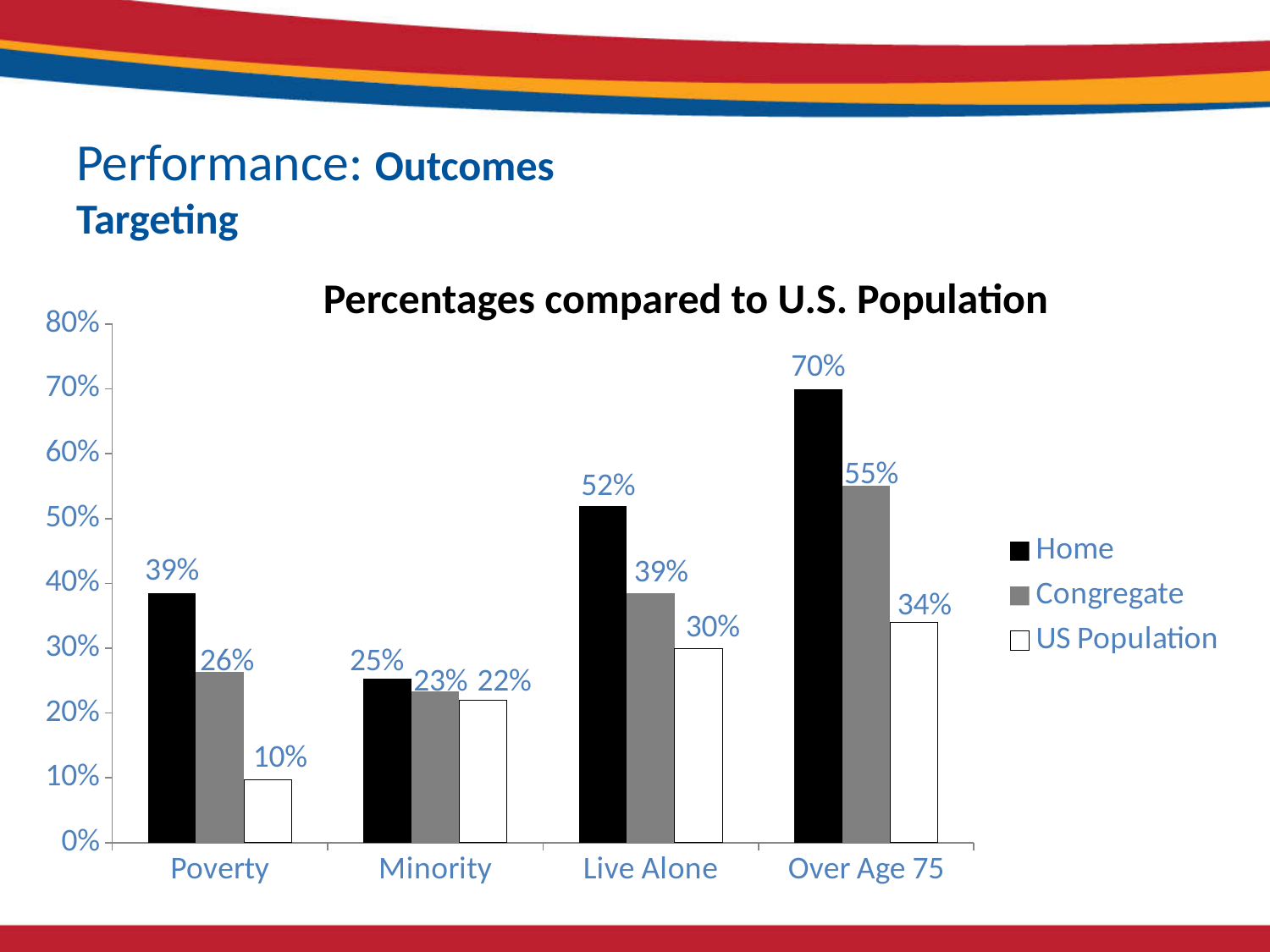
What is the Home value for Poverty? 39% What is the title of the chart? Percentages compared to U.S. Population Which category has the lowest US Population value? Poverty What is the difference between the Home and Congregate values for Over Age 75? 15% Which is larger for Minority: the Home value or the US Population value? Home How many series does the legend list? 3 What kind of chart is this? Bar chart Which category has the highest Home value? Over Age 75 How many categories are shown on the x axis? 4 What is the US Population value for Over Age 75? 34% What is the Congregate value for Live Alone? 39% What is the difference between the Home and US Population values for Poverty? 29%